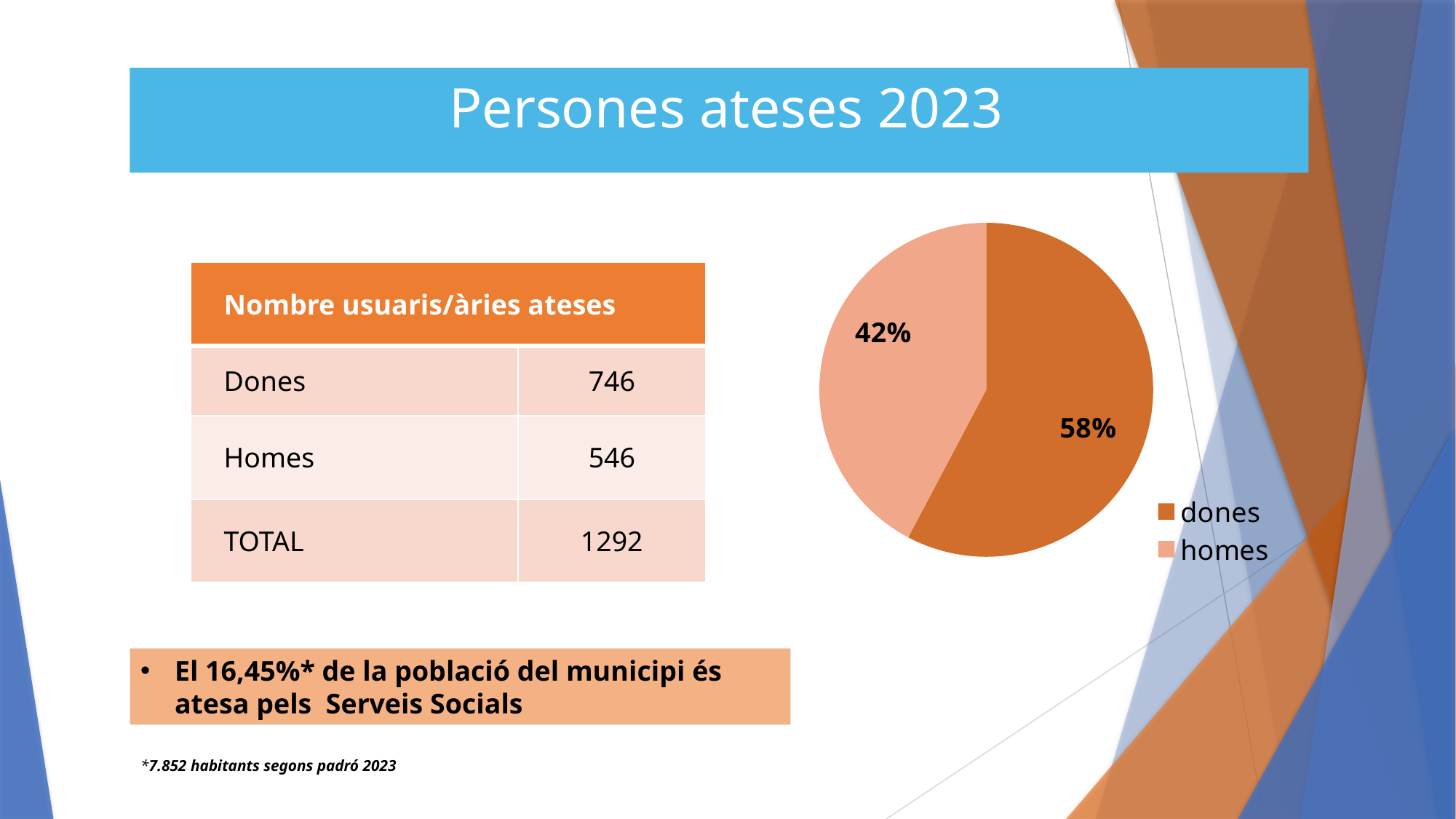
What share of the pie chart does the 'dones' slice represent? 58% Which slice of the pie chart is the largest? dones How many entries does the pie chart legend list? 2 What is the difference in percentage points between the 'dones' and 'homes' slices of the pie chart? 16 percentage points Which is larger in the pie chart, the 'dones' slice or the 'homes' slice? dones Which legend entry in the pie chart is shown in the darker orange colour? dones What kind of chart is shown on the slide? pie chart Is the share of the 'homes' slice in the pie chart greater or less than 50%? less Where is the legend positioned relative to the pie chart? bottom right What share of the pie chart does the 'homes' slice represent? 42% Which slice of the pie chart is the smallest? homes How many slices does the pie chart have? 2